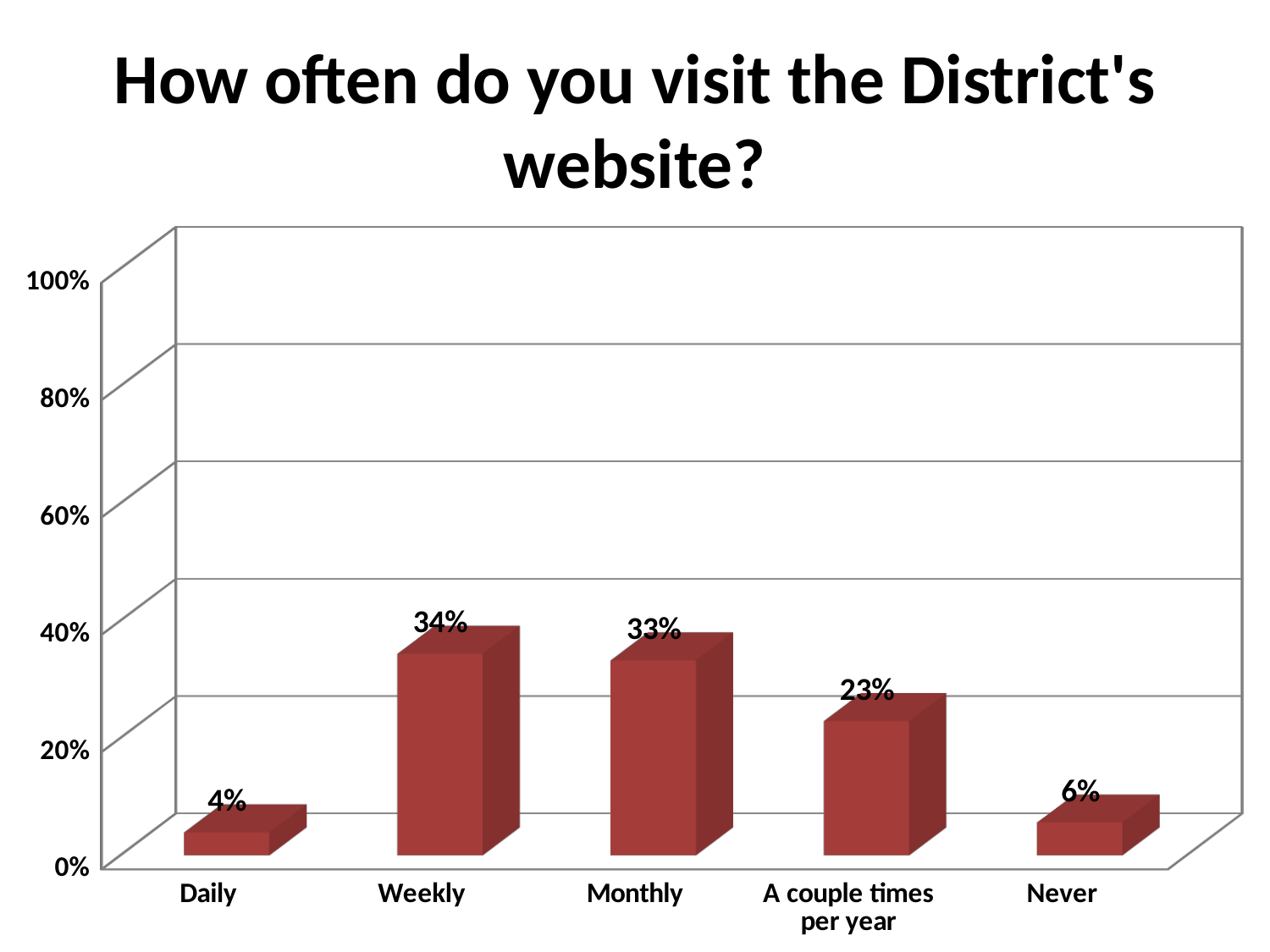
What is the difference between the Monthly and 'A couple times per year' values? 10% What is the value for 'A couple times per year'? 23% What percentage of respondents visit the District's website weekly? 34% Which is larger, the value for Never or the value for Daily? Never How many categories are shown on the x axis? 5 Which category has the highest value? Weekly Is the value for Monthly greater or less than 40%? less What is the value shown for the Daily category? 4% What percentage of respondents said they never visit the District's website? 6% What is the title of the chart? How often do you visit the District's website? What kind of chart is shown on the slide? bar chart Which category has the lowest value? Daily